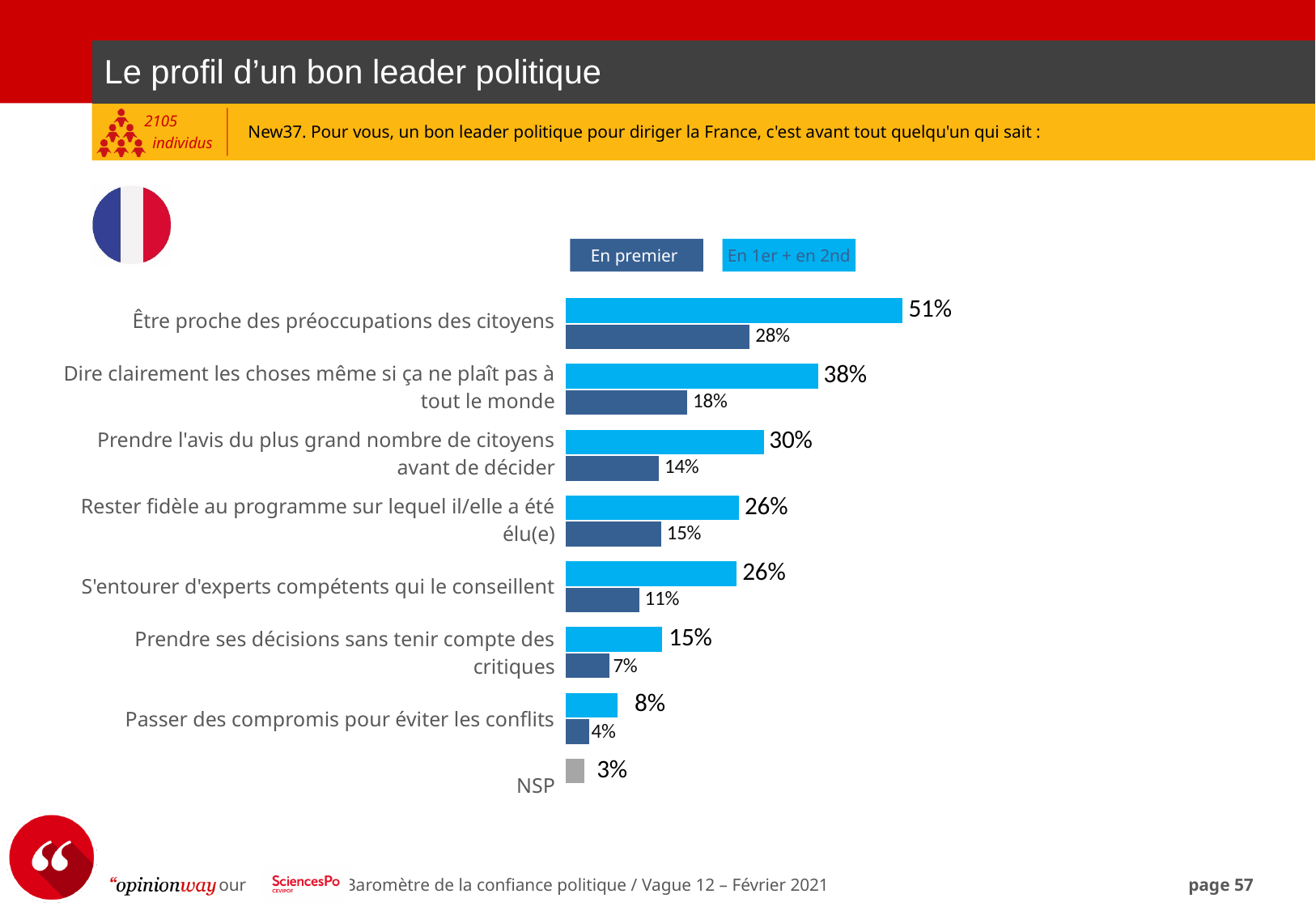
Which category has the highest 'En 1er + en 2nd' value? Être proche des préoccupations des citoyens Which category has the lowest 'En premier' value? Passer des compromis pour éviter les conflits What kind of chart is shown on the slide? Bar chart How many series does the legend list? 2 What is the difference between the 'En 1er + en 2nd' and 'En premier' values for 'Prendre l'avis du plus grand nombre de citoyens avant de décider'? 16 percentage points How many categories are shown on the chart, including NSP? 8 Which is larger: the 'En premier' value for 'Rester fidèle au programme sur lequel il/elle a été élu(e)' or for 'Prendre l'avis du plus grand nombre de citoyens avant de décider'? Rester fidèle au programme sur lequel il/elle a été élu(e) What is the 'En premier' value for 'Dire clairement les choses même si ça ne plaît pas à tout le monde'? 18% What is the value shown for 'NSP'? 3% Which legend entry is shown in dark blue? En premier What is the 'En 1er + en 2nd' value for 'Être proche des préoccupations des citoyens'? 51% What is the 'En premier' value for 'S'entourer d'experts compétents qui le conseillent'? 11%